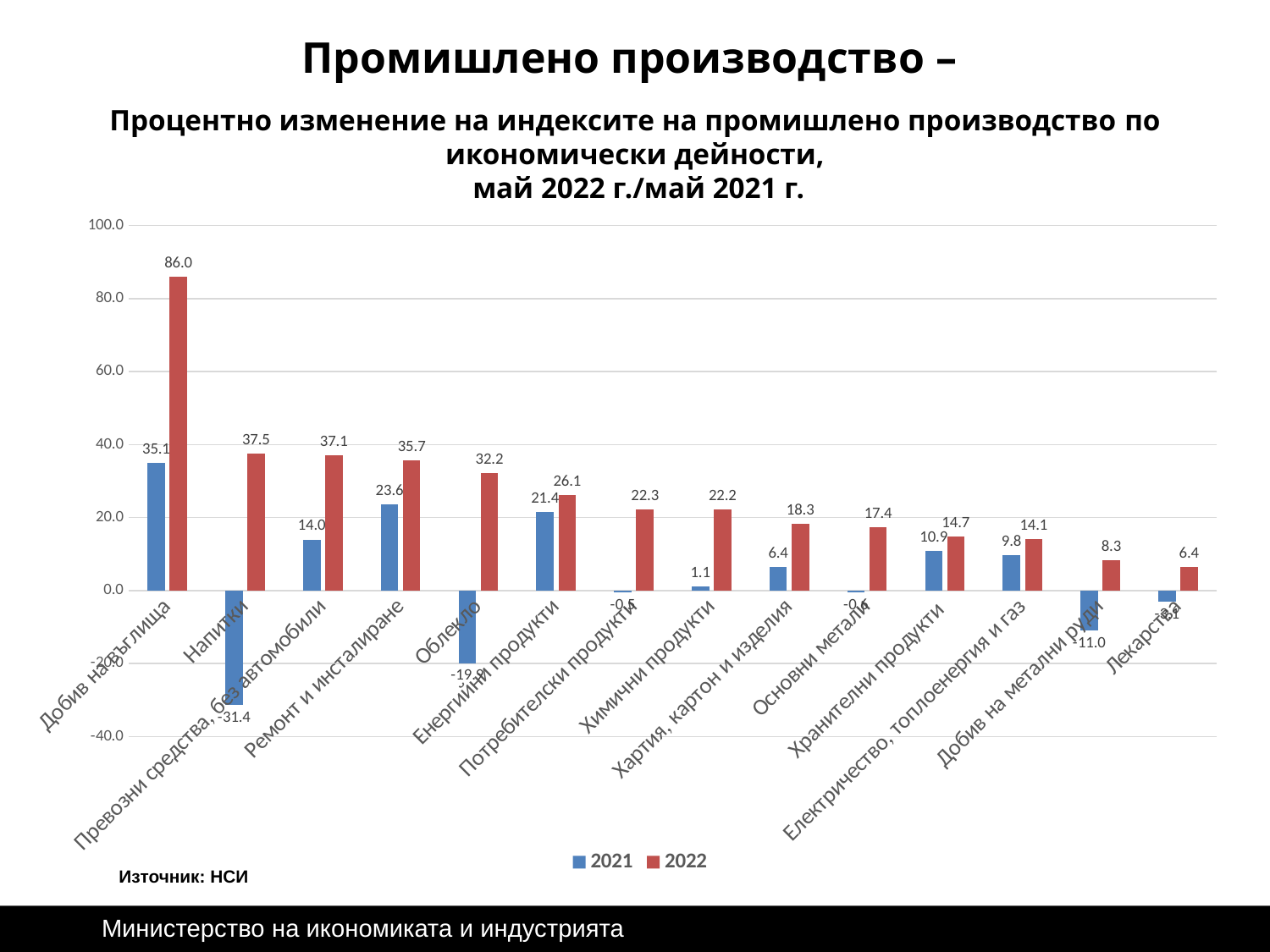
How many categories are shown on the x axis? 14 How many series does the legend list? 2 What is the 2022 value for Добив на въглища? 86.0 What is the 2021 value for Напитки? -31.4 Which is larger for Енергийни продукти, the 2021 value or the 2022 value? 2022 What kind of chart is shown on the slide? Bar chart Which colour represents the 2022 series in the legend? Red Is the 2022 value for Облекло greater or less than 20.0? greater Which category has the highest 2022 value? Добив на въглища What is the 2022 value for Хранителни продукти? 14.7 What is the difference between the 2022 and 2021 values for Ремонт и инсталиране? 12.1 Which category has the lowest 2021 value? Напитки